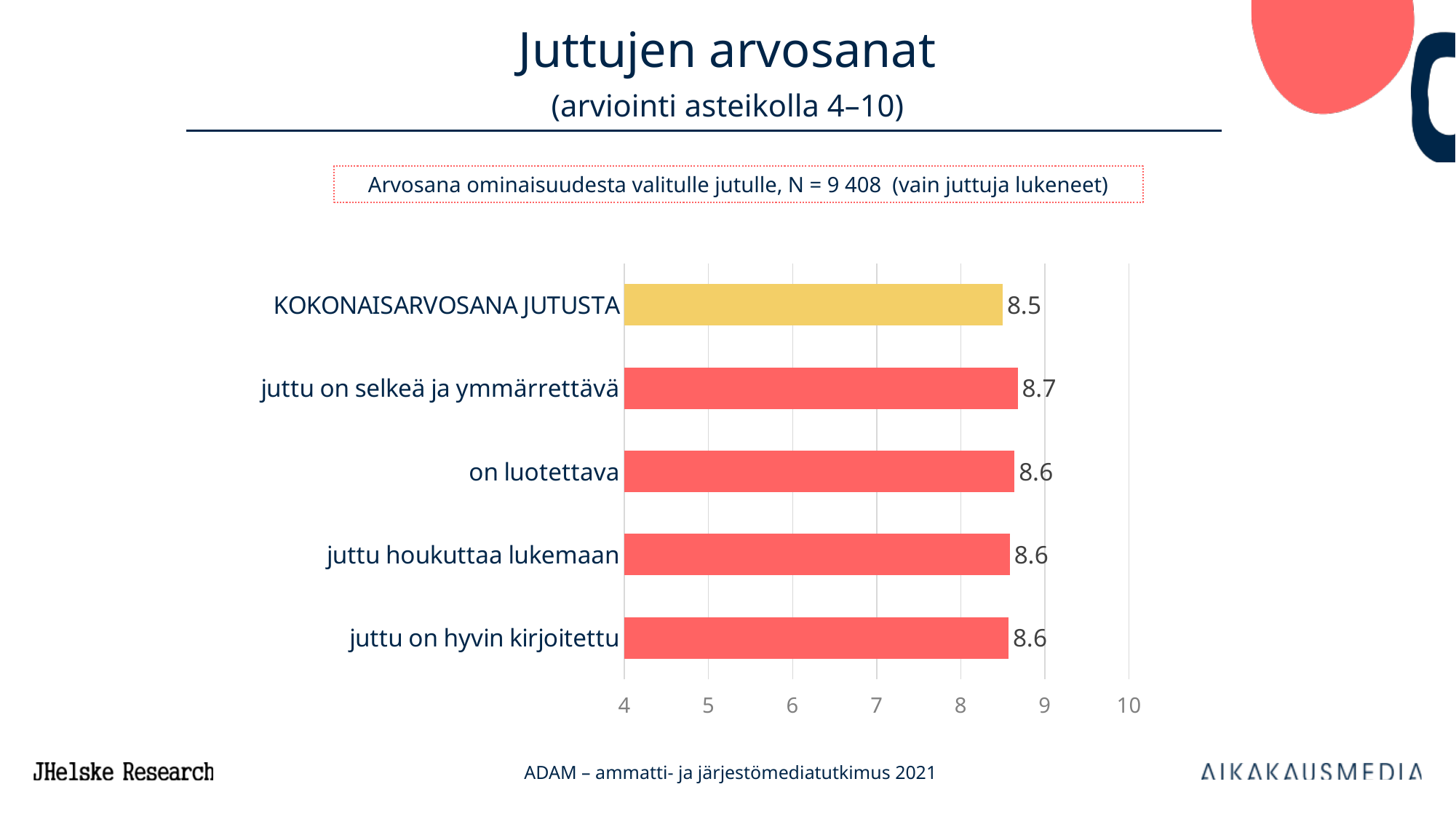
What is the value for "on luotettava"? 8.6 What is the title of the slide? Juttujen arvosanat How many categories are shown in the chart? 5 What is the value for "juttu on selkeä ja ymmärrettävä"? 8.7 What is the difference between the values for "juttu on selkeä ja ymmärrettävä" and "KOKONAISARVOSANA JUTUSTA"? 0.2 Which is larger, the value for "juttu on selkeä ja ymmärrettävä" or the value for "KOKONAISARVOSANA JUTUSTA"? juttu on selkeä ja ymmärrettävä What is the value for "juttu on hyvin kirjoitettu"? 8.6 Which category has the highest value? juttu on selkeä ja ymmärrettävä Is the value for "on luotettava" greater or less than 8? greater What kind of chart is shown on the slide? bar chart Which category has the lowest value? KOKONAISARVOSANA JUTUSTA What is the value for "KOKONAISARVOSANA JUTUSTA"? 8.5